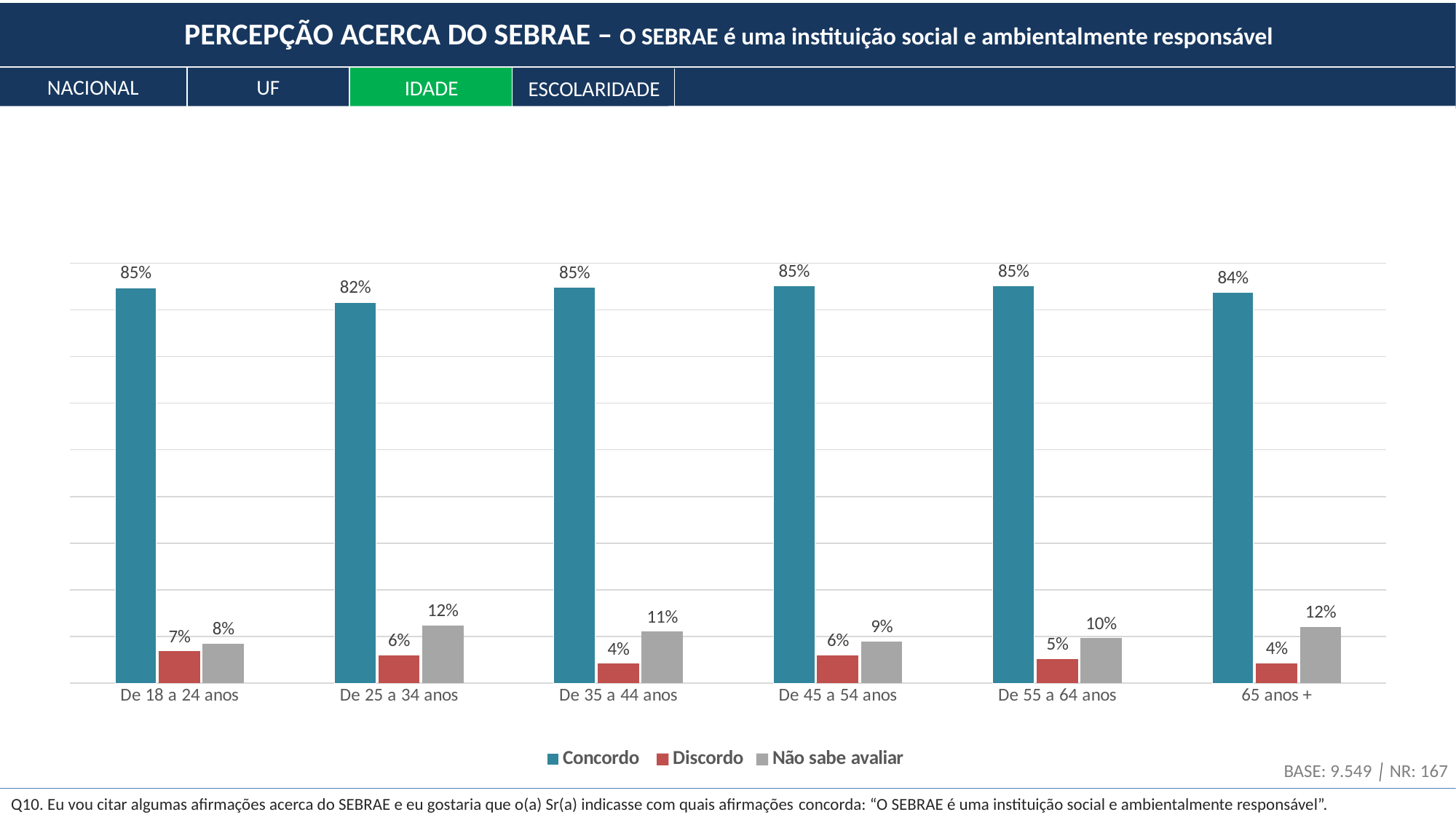
Which tab is highlighted in green above the chart? IDADE What kind of chart is shown on the slide? bar chart What is the total of Concordo, Discordo and Não sabe avaliar for De 18 a 24 anos? 100% Which is larger, the Discordo value for De 45 a 54 anos or the Discordo value for De 55 a 64 anos? De 45 a 54 anos Which age group has the highest Discordo value? De 18 a 24 anos How many age groups are shown on the x axis? 6 How many series does the legend list? 3 What is the Discordo value for 65 anos +? 4% What is the difference between the Não sabe avaliar values for De 25 a 34 anos and De 18 a 24 anos? 4% What is the Concordo value for De 25 a 34 anos? 82% What is the Não sabe avaliar value for De 35 a 44 anos? 11% Which age group has the lowest Concordo value? De 25 a 34 anos